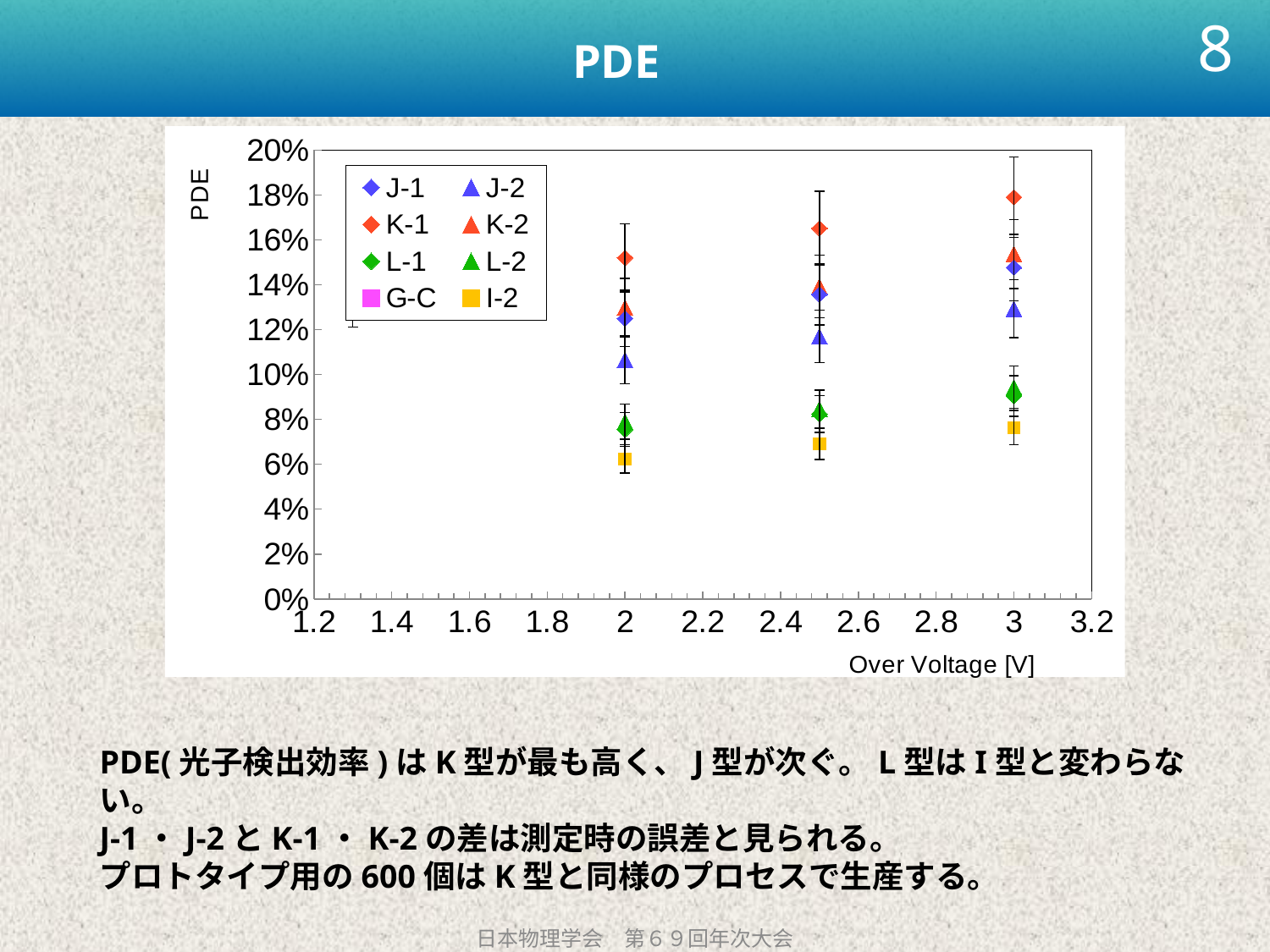
Is the PDE for K-1 at 3 V greater or less than 16%? greater At an over voltage of 2.5 V, which has the higher PDE, K-1 or L-1? K-1 What kind of chart is shown on the slide? scatter chart At how many over-voltage values are data points plotted? 3 What is the label of the x axis? Over Voltage [V] Is the PDE for I-2 at 2 V greater or less than 8%? less Which series has the lowest PDE at an over voltage of 2 V? I-2 Does the PDE for K-1 rise or fall as the over voltage increases from 2 V to 3 V? rise How many series does the legend list? 8 Is the PDE for K-1 at 2 V greater or less than 14%? greater Which series has the highest PDE at an over voltage of 3 V? K-1